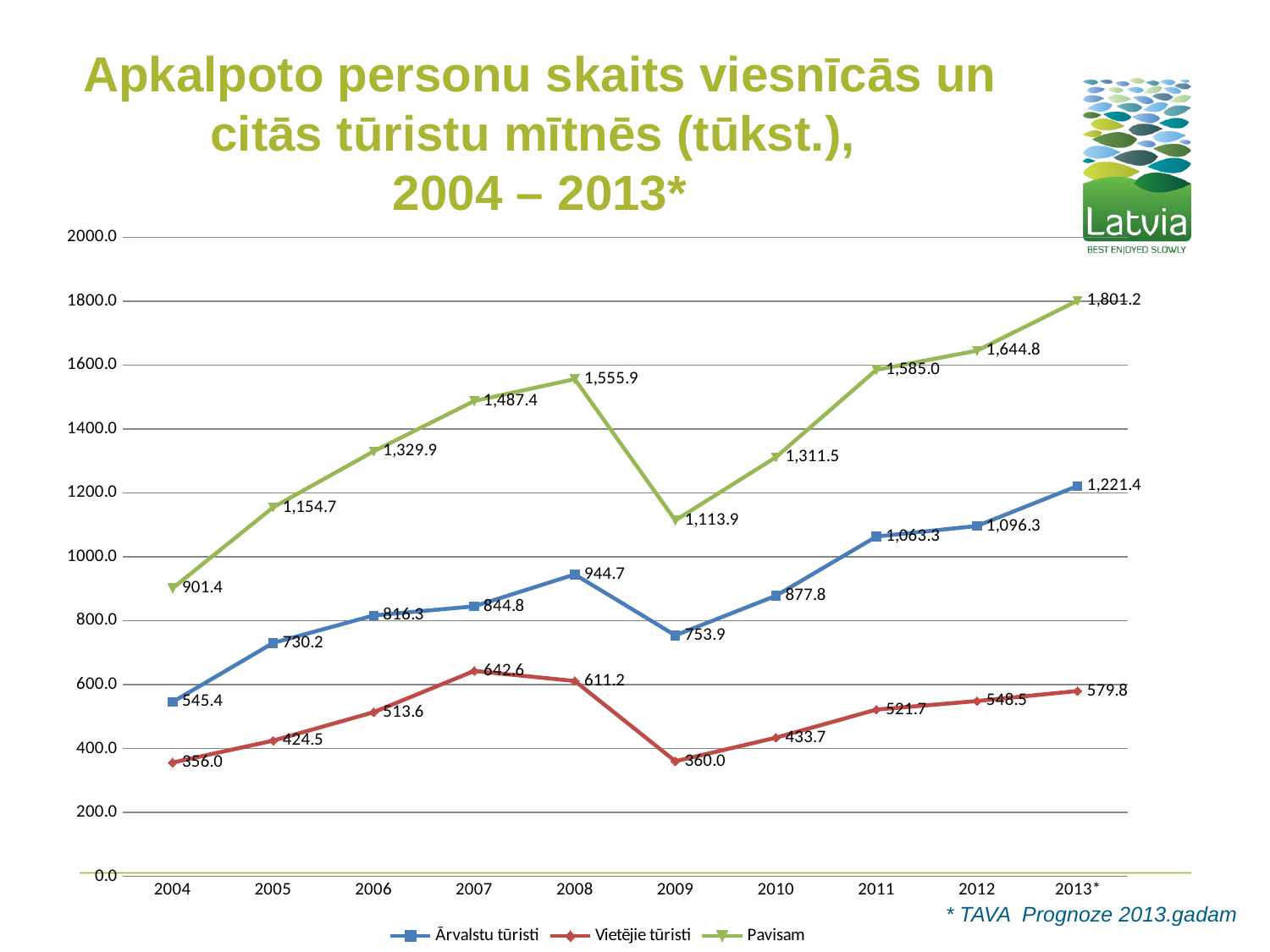
What type of chart is shown on the slide? line chart Which series is drawn in green? Pavisam Do the Ārvalstu tūristi values rise or fall from 2009 to 2013*? rise What is the value for Pavisam in 2013*? 1,801.2 How many series does the legend list? 3 What is the value for Vietējie tūristi in 2007? 642.6 In which year is the Vietējie tūristi series highest? 2007 What is the difference between the Pavisam values for 2008 and 2009? 442.0 What is the value for Ārvalstu tūristi in 2008? 944.7 How many years are plotted along the x axis? 10 In which year is the Pavisam series lowest? 2004 Which is larger: Ārvalstu tūristi in 2009 or Ārvalstu tūristi in 2010? Ārvalstu tūristi in 2010